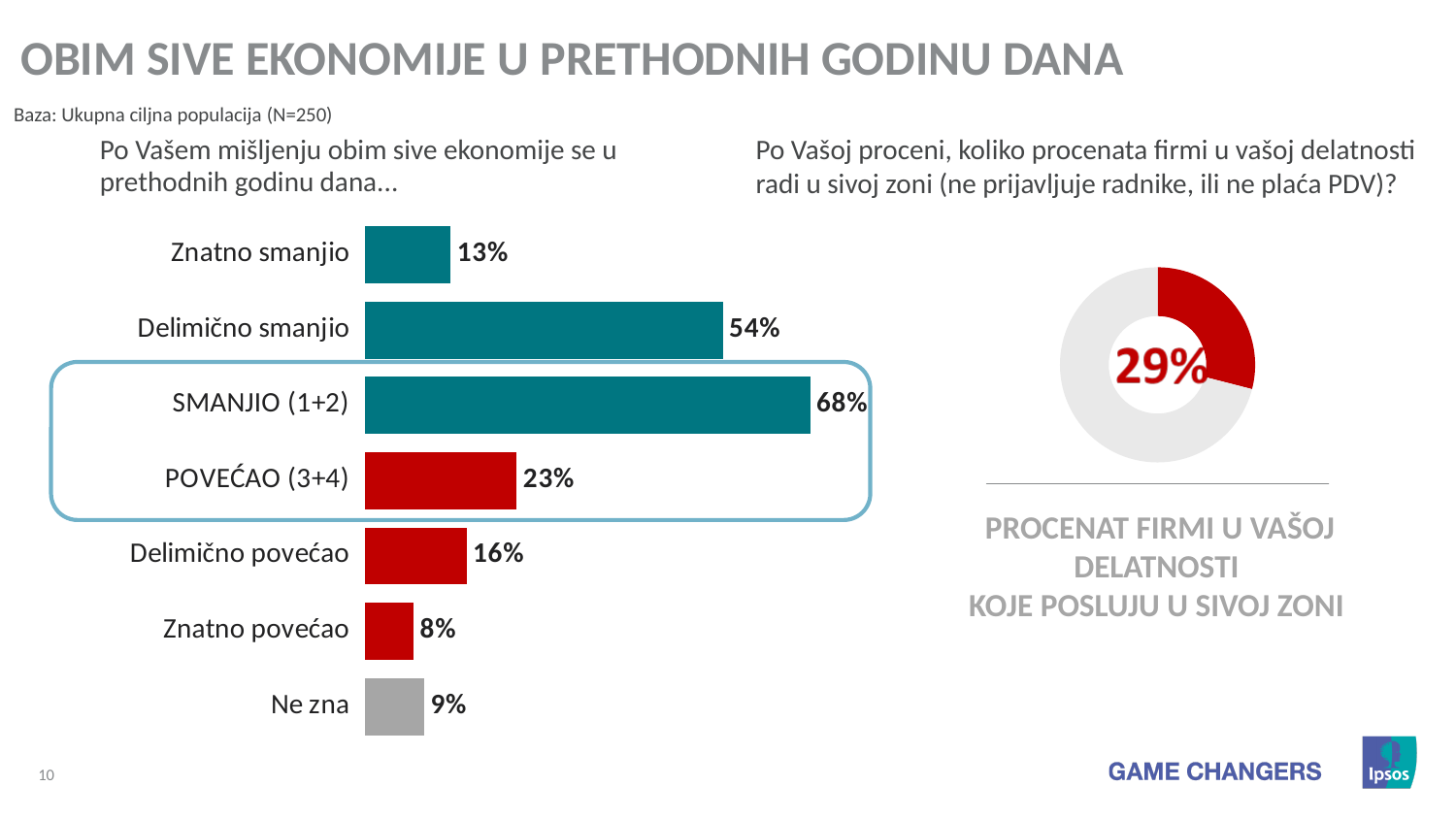
What type of chart is shown on the left side of the slide? Bar chart In the doughnut chart on the right, what percentage of firms is shown as operating in the grey zone? 29% In the bar chart on the left, which category has the highest value? SMANJIO (1+2) In the bar chart on the left, what colour are the bars for 'POVEĆAO (3+4)', 'Delimično povećao' and 'Znatno povećao'? Red In the bar chart on the left, what is the value for 'Znatno povećao'? 8% In the bar chart on the left, what is the difference between 'SMANJIO (1+2)' and 'POVEĆAO (3+4)'? 45% How many categories are shown in the bar chart on the left? 7 In the bar chart on the left, which category has the lowest value? Znatno povećao In the bar chart on the left, what is the value for 'Ne zna'? 9% In the bar chart on the left, which is larger: 'Znatno smanjio' or 'Delimično povećao'? Delimično povećao In the bar chart on the left, what is the value for 'Delimično smanjio'? 54% What type of chart is shown on the right side of the slide? Doughnut chart